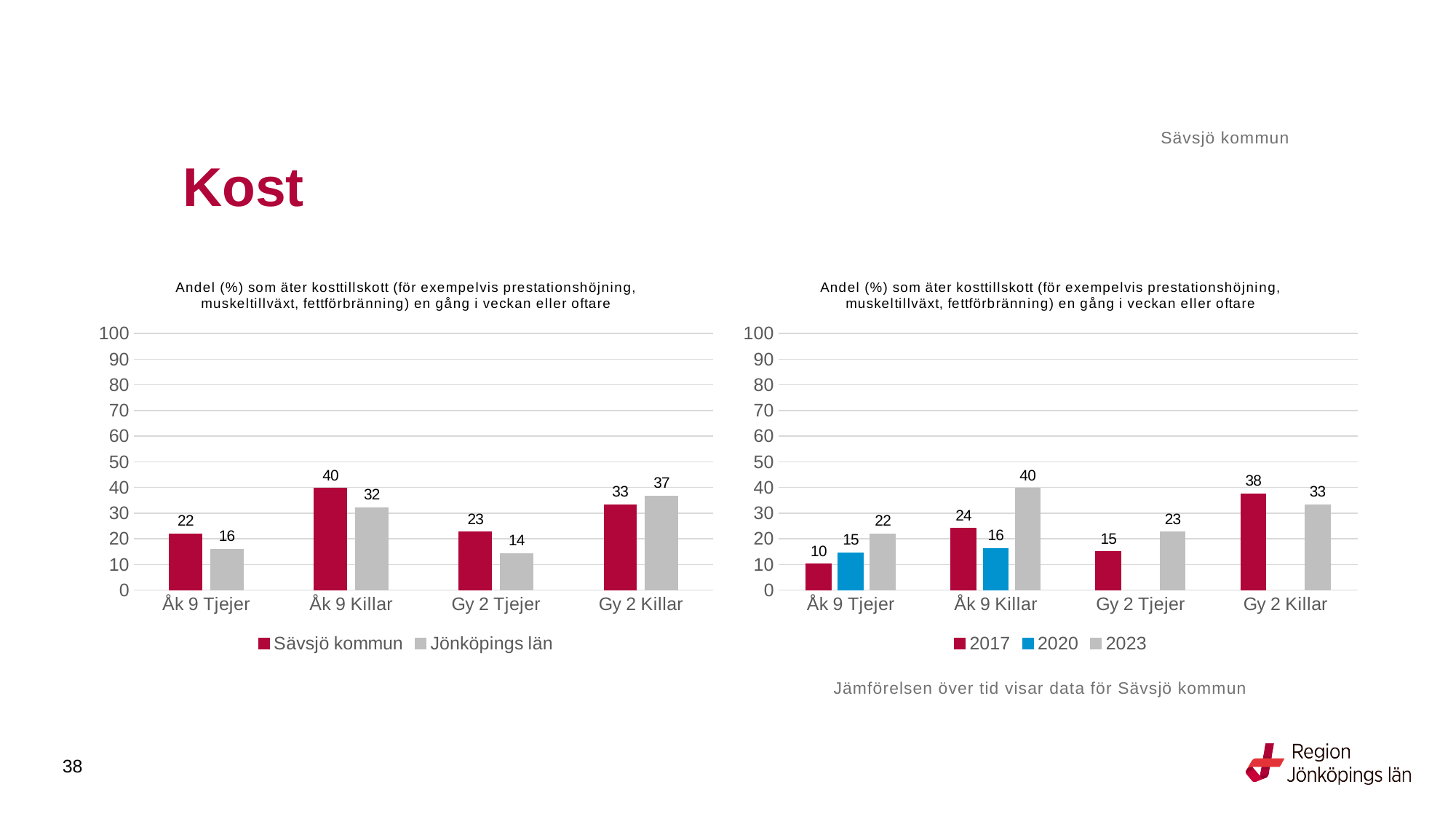
What kind of chart is the right chart? Bar chart In the left chart, what is the value for Sävsjö kommun for Åk 9 Killar? 40 In the left chart, which category has the highest value for Jönköpings län? Gy 2 Killar In the left chart, what is the difference between Sävsjö kommun and Jönköpings län for Gy 2 Tjejer? 9 In the left chart, how many series does the legend list? 2 In the left chart, what is the value for Jönköpings län for Gy 2 Tjejer? 14 In the right chart, what is the value for 2017 for Åk 9 Tjejer? 10 In the right chart, how many series does the legend list? 3 In the right chart, which category has the lowest value for 2017? Åk 9 Tjejer In the right chart, what is the value for 2023 for Åk 9 Killar? 40 In the left chart, which is larger for Gy 2 Killar: Sävsjö kommun or Jönköpings län? Jönköpings län In the right chart, what is the difference between 2023 and 2017 for Åk 9 Killar? 16